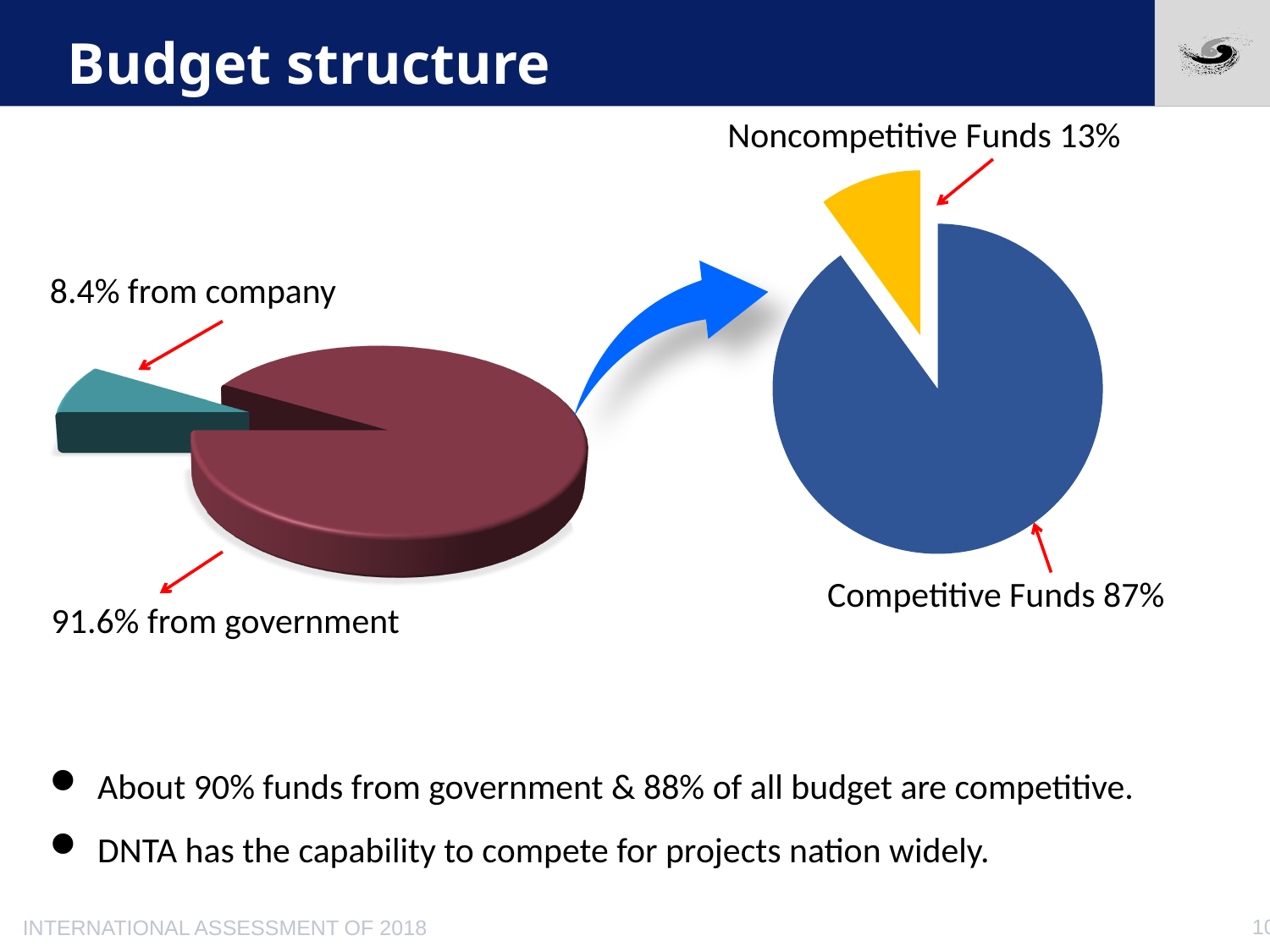
In the left pie chart, which source accounts for the largest share of the budget? government In the right pie chart, which is larger, Competitive Funds or Noncompetitive Funds? Competitive Funds In the right pie chart, what share is Competitive Funds? 87% In the left pie chart, what is the difference between the government share and the company share? 83.2% What kind of chart is the left chart on the slide? pie chart In the left pie chart, what share of the budget comes from the company? 8.4% In the left pie chart, how many slices are shown? 2 In the right pie chart, what share is Noncompetitive Funds? 13% In the right pie chart, what colour is the Noncompetitive Funds slice? yellow In the left pie chart, what share of the budget comes from the government? 91.6% In the right pie chart, what is the difference between the Competitive Funds share and the Noncompetitive Funds share? 74% In the left pie chart, which source accounts for the smallest share of the budget? company